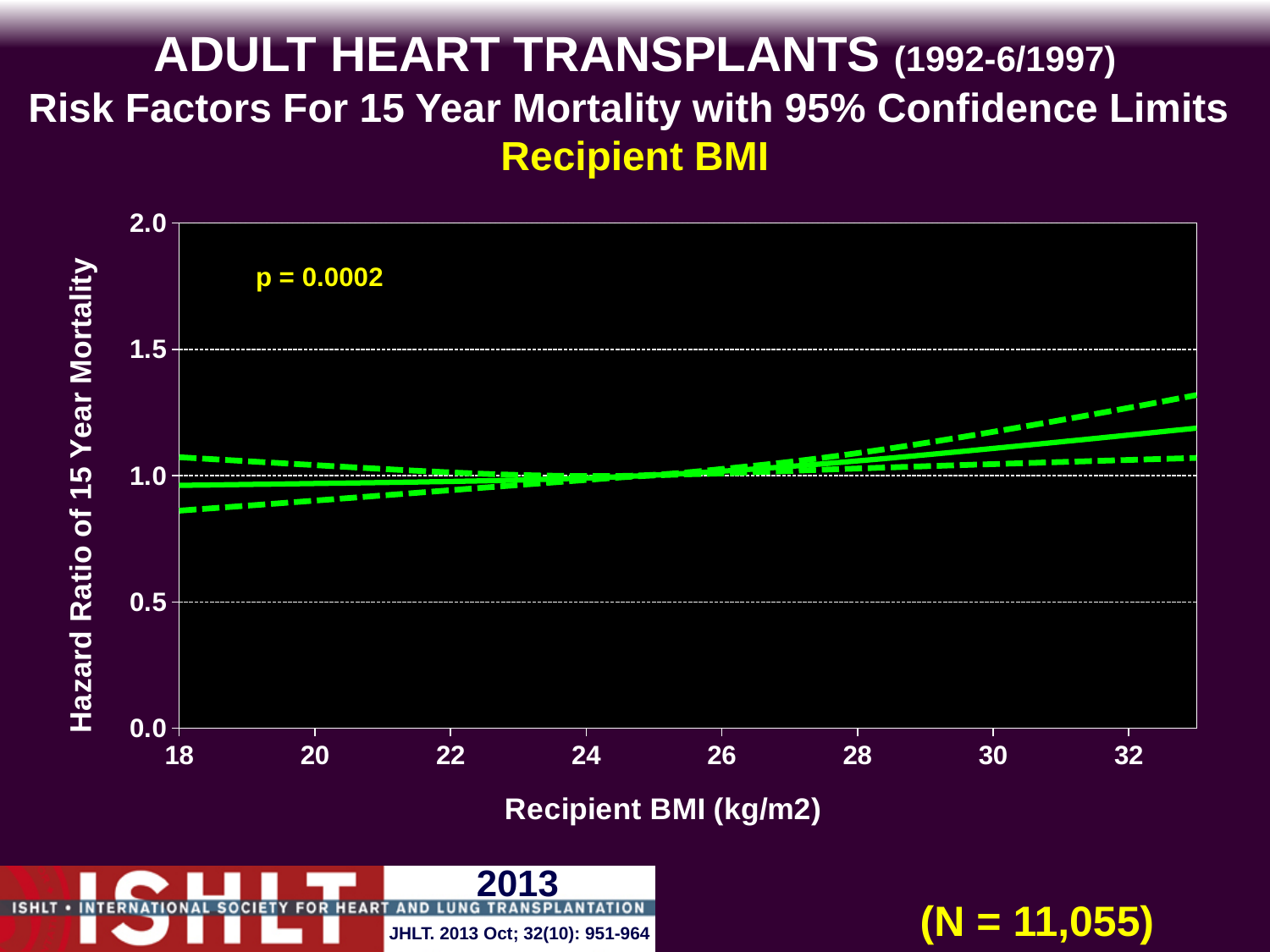
Does the solid hazard ratio line rise or fall as Recipient BMI increases from 18 to 32? rise Is the hazard ratio (solid line) at a Recipient BMI of 24 greater or less than 1.5? less Is the upper 95% confidence limit (upper dashed line) at a Recipient BMI of 32 greater or less than 1.5? less How many lines are plotted on the chart? 3 Is the upper 95% confidence limit (upper dashed line) at a Recipient BMI of 32 greater or less than 1.0? greater What is the label of the y-axis? Hazard Ratio of 15 Year Mortality What is the highest value shown on the y-axis? 2.0 What is the p-value shown on the chart? p = 0.0002 What kind of chart is shown on the slide? line chart